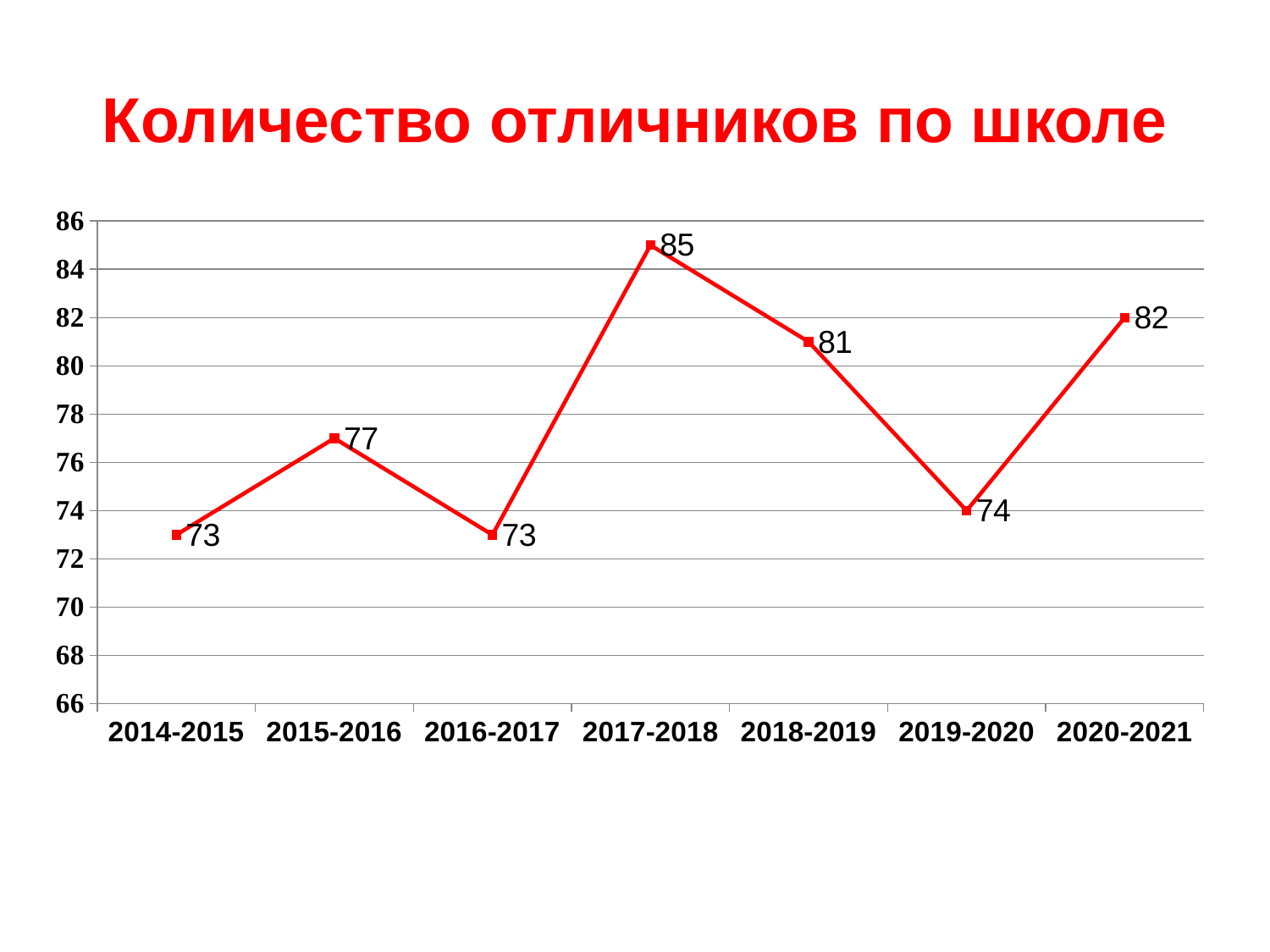
What is the difference between the values for 2017-2018 and 2019-2020? 11 What is the value for 2020-2021? 82 Which school year has the highest value? 2017-2018 How many school years are plotted on the chart? 7 What is the value for 2015-2016? 77 Does the value rise or fall from 2018-2019 to 2019-2020? fall What is the title of the chart? Количество отличников по школе Is the value for 2019-2020 greater or less than 80? less Which school year has the lowest value? 2014-2015 and 2016-2017 What kind of chart is shown on the slide? line chart What is the value for 2017-2018? 85 Which is larger, the value for 2018-2019 or the value for 2020-2021? 2020-2021